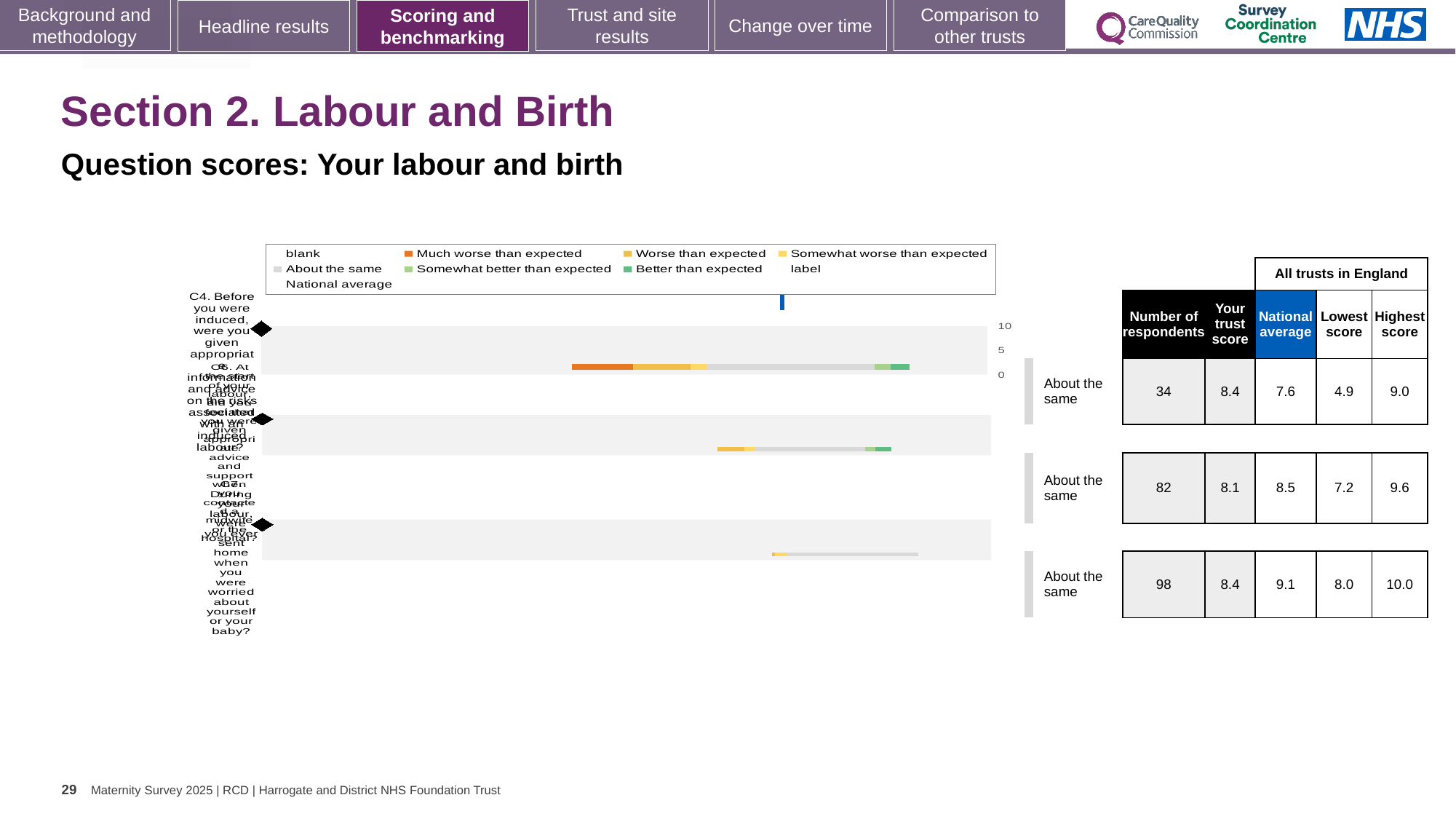
In the chart legend, what colour represents 'Much worse than expected'? orange In the table next to the chart, what is the trust score for the second question row? 8.1 How many question rows are plotted in the chart? 3 What is the difference between the highest score and the lowest score for the first question row (C4)? 4.1 Which question row has the largest number of respondents in the table? the third row (98) In the table next to the chart, what is the number of respondents for the first question row (C4)? 34 What kind of chart is shown on the slide? bar chart For the first question row (C4), which is larger: the trust score or the national average? the trust score (8.4) In the chart legend, what colour represents 'Better than expected'? green In the table next to the chart, what is the highest score for the third question row? 10.0 In the table next to the chart, what is the national average for the third question row? 9.1 What benchmark label is shown beside each of the three question rows? About the same